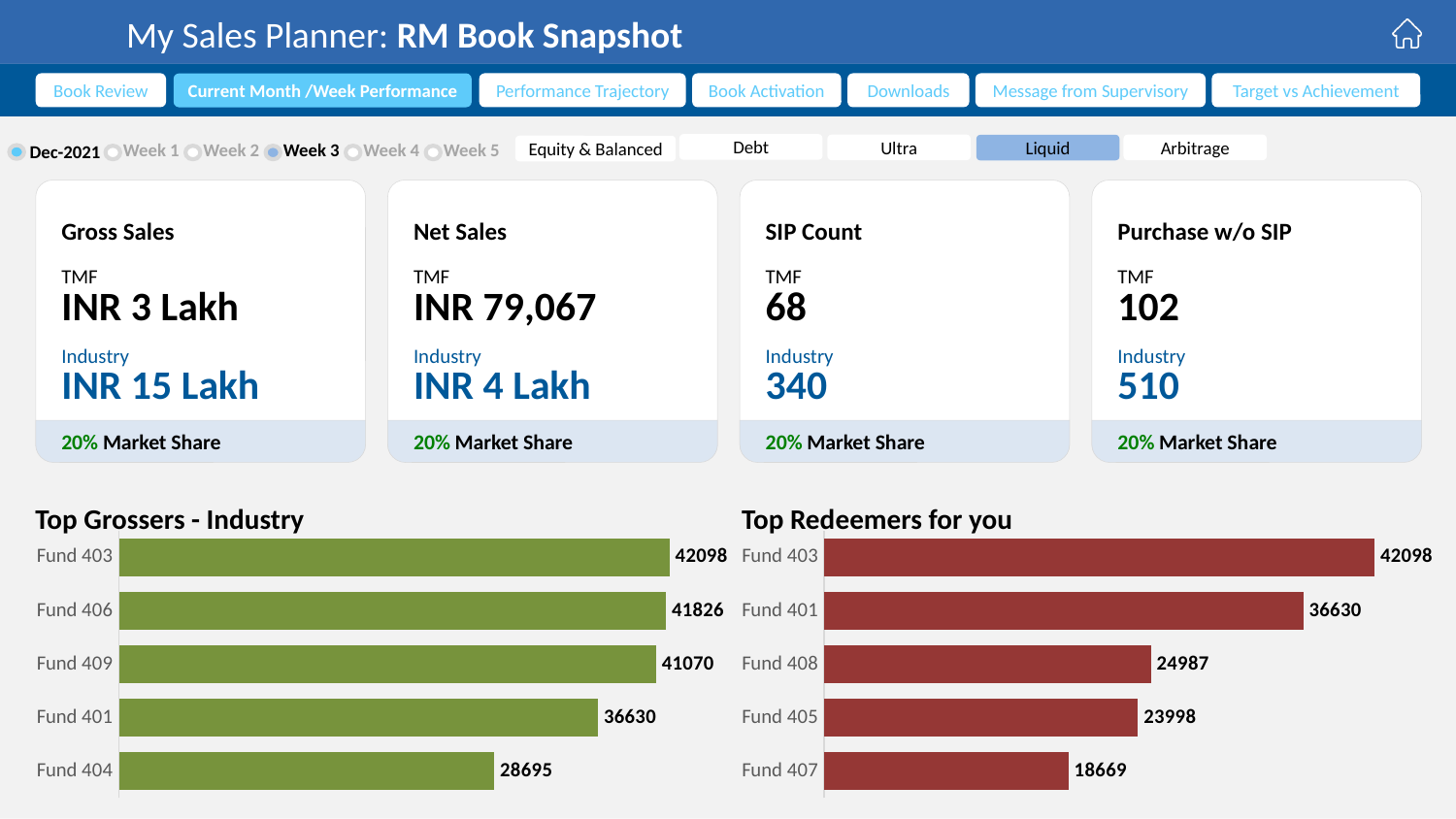
In the 'Top Redeemers for you' chart, what is the value for Fund 407? 18669 In the 'Top Grossers - Industry' chart, how many funds are shown? 5 In the 'Top Redeemers for you' chart, which fund has the highest value? Fund 403 In the 'Top Redeemers for you' chart, what is the value for Fund 408? 24987 In the 'Top Grossers - Industry' chart, what is the value for Fund 409? 41070 What colour are the bars in the 'Top Grossers - Industry' chart? Green What type of chart is 'Top Redeemers for you'? Bar chart In the 'Top Grossers - Industry' chart, what is the value for Fund 406? 41826 In the 'Top Redeemers for you' chart, which is larger, Fund 405 or Fund 407? Fund 405 In the 'Top Grossers - Industry' chart, which fund has the lowest value? Fund 404 In the 'Top Redeemers for you' chart, what is the difference between Fund 401 and Fund 408? 11643 In the 'Top Grossers - Industry' chart, what is the difference between Fund 403 and Fund 404? 13403